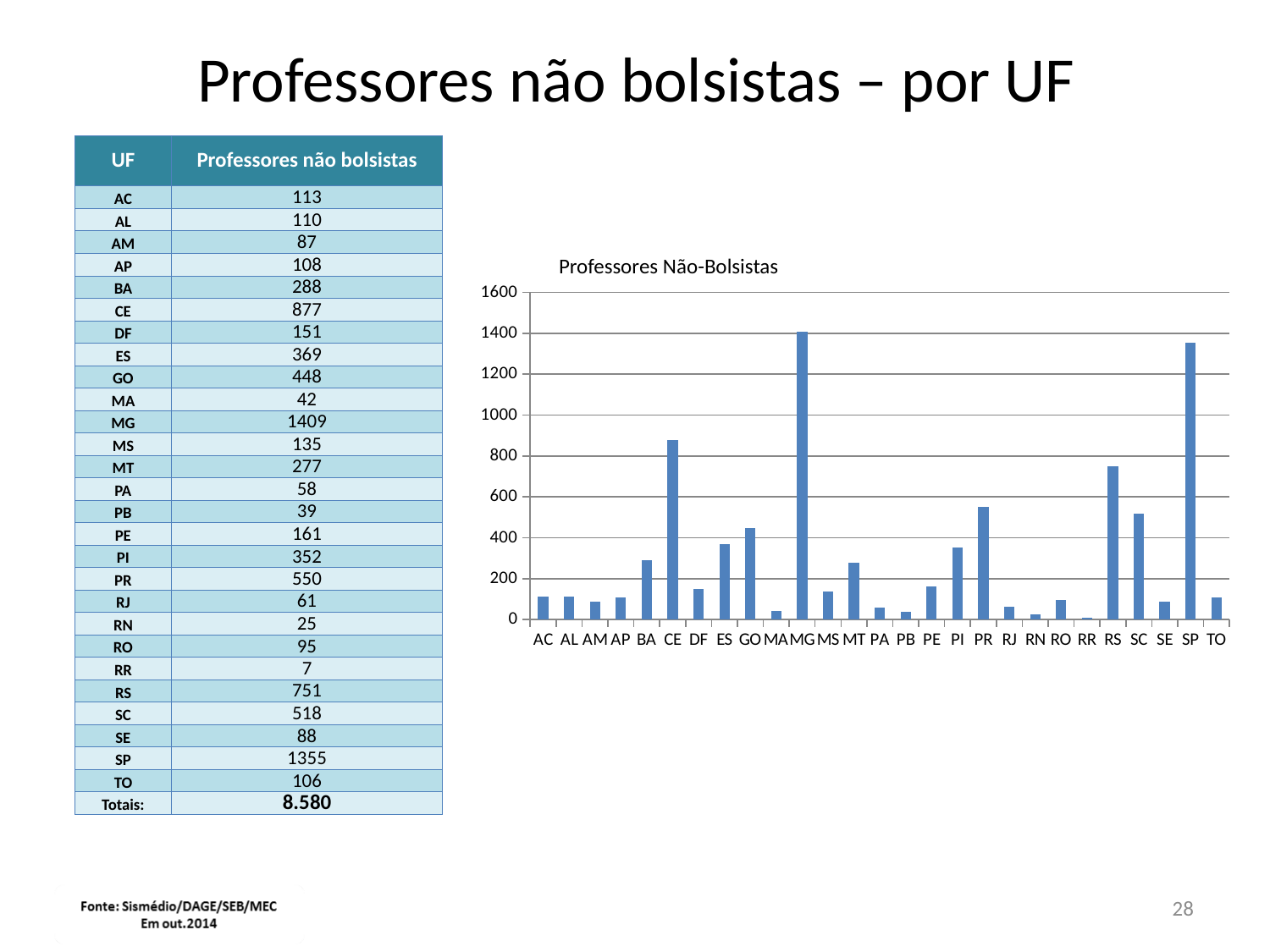
What is the value for SP? 1355 Which is larger, the value for CE or the value for RS? CE How many UF categories are plotted on the x axis of the chart? 27 Is the value for CE greater or less than 800? greater Which UF has the highest number of professores não bolsistas? MG What is the title of the chart? Professores Não-Bolsistas Which UF has the lowest number of professores não bolsistas? RR What is the value for MG? 1409 What kind of chart is shown on the slide? bar chart What is the difference between the values for MG and SP? 54 Is the value for PR greater or less than 600? less What is the value for CE? 877